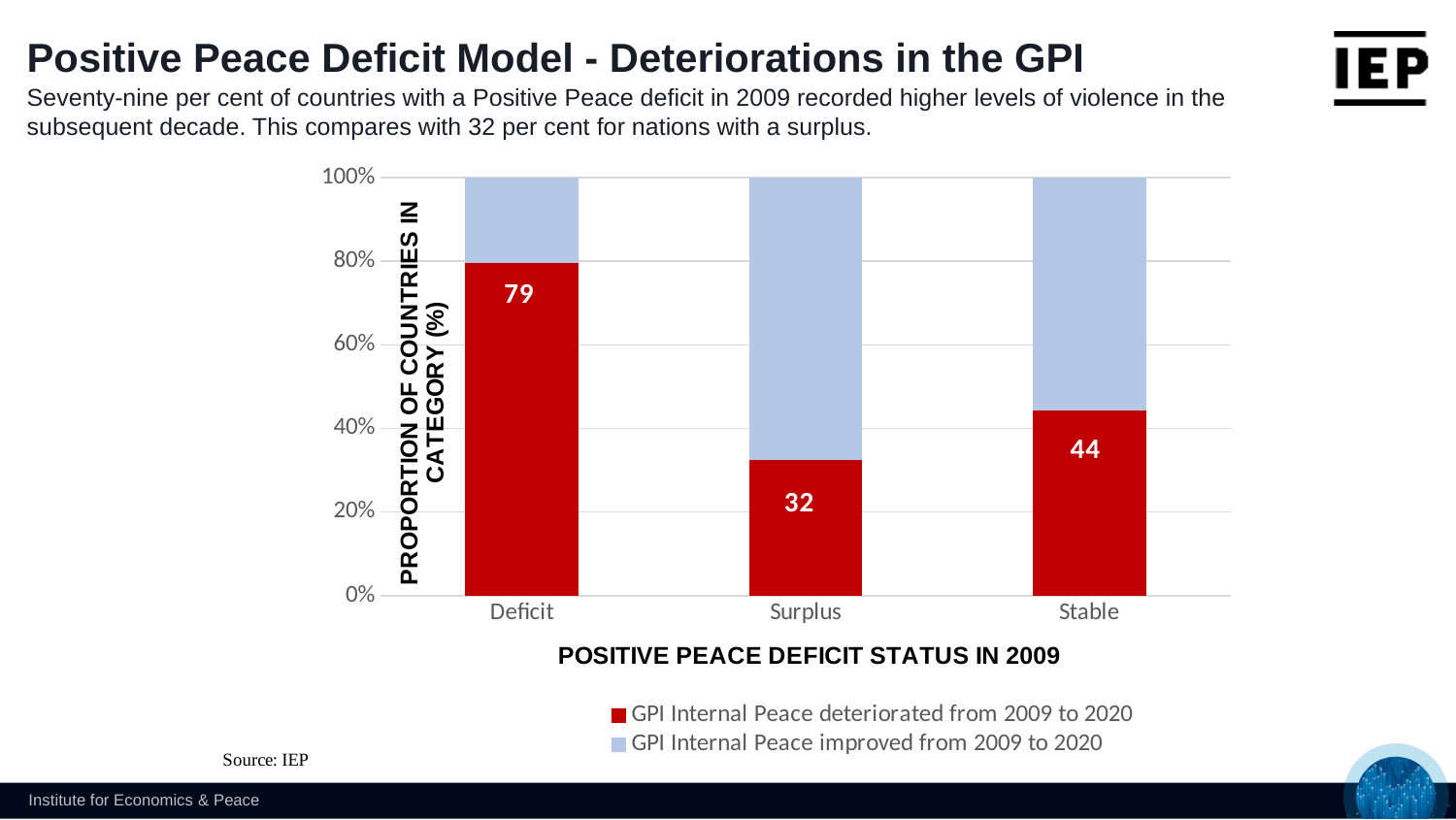
What is the value for Deficit in the 'GPI Internal Peace deteriorated from 2009 to 2020' series? 79 Which category has the highest proportion of countries whose GPI Internal Peace deteriorated from 2009 to 2020? Deficit Is the 'GPI Internal Peace improved from 2009 to 2020' value for Surplus greater or less than 60%? greater Which is larger, the deteriorated value for Stable or for Surplus? Stable What is the difference between the deteriorated values for Stable and Surplus? 12 What kind of chart is shown on the slide? Stacked bar chart What is the value for Surplus in the 'GPI Internal Peace deteriorated from 2009 to 2020' series? 32 What is the difference between the deteriorated values for Deficit and Surplus? 47 How many categories are shown on the x axis? 3 What is the value for Stable in the 'GPI Internal Peace deteriorated from 2009 to 2020' series? 44 Which category has the lowest proportion of countries whose GPI Internal Peace deteriorated from 2009 to 2020? Surplus How many series does the legend list? 2